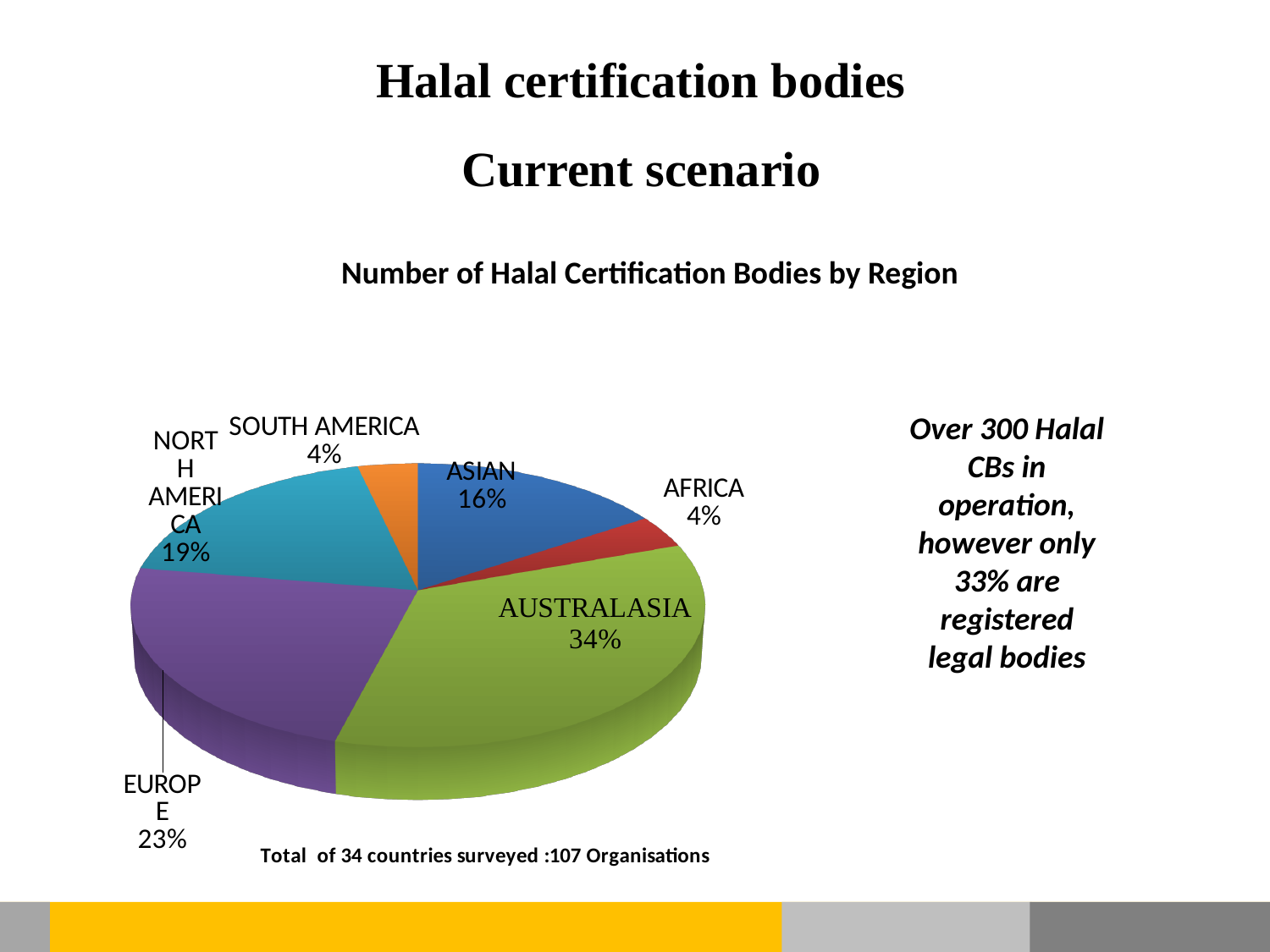
What is the title of the chart? Number of Halal Certification Bodies by Region What share of the pie does AUSTRALASIA hold? 34% What percentage is shown for AFRICA? 4% What percentage is shown for NORTH AMERICA? 19% Which region has the largest slice of the pie? AUSTRALASIA How many regions are shown in the pie chart? 6 What is the difference in percentage points between AUSTRALASIA and EUROPE? 11 What is the difference in percentage points between NORTH AMERICA and ASIAN? 3 What percentage is shown for EUROPE? 23% Which region has a larger share, EUROPE or NORTH AMERICA? EUROPE What percentage is shown for ASIAN? 16% What kind of chart is shown on the slide? Pie chart